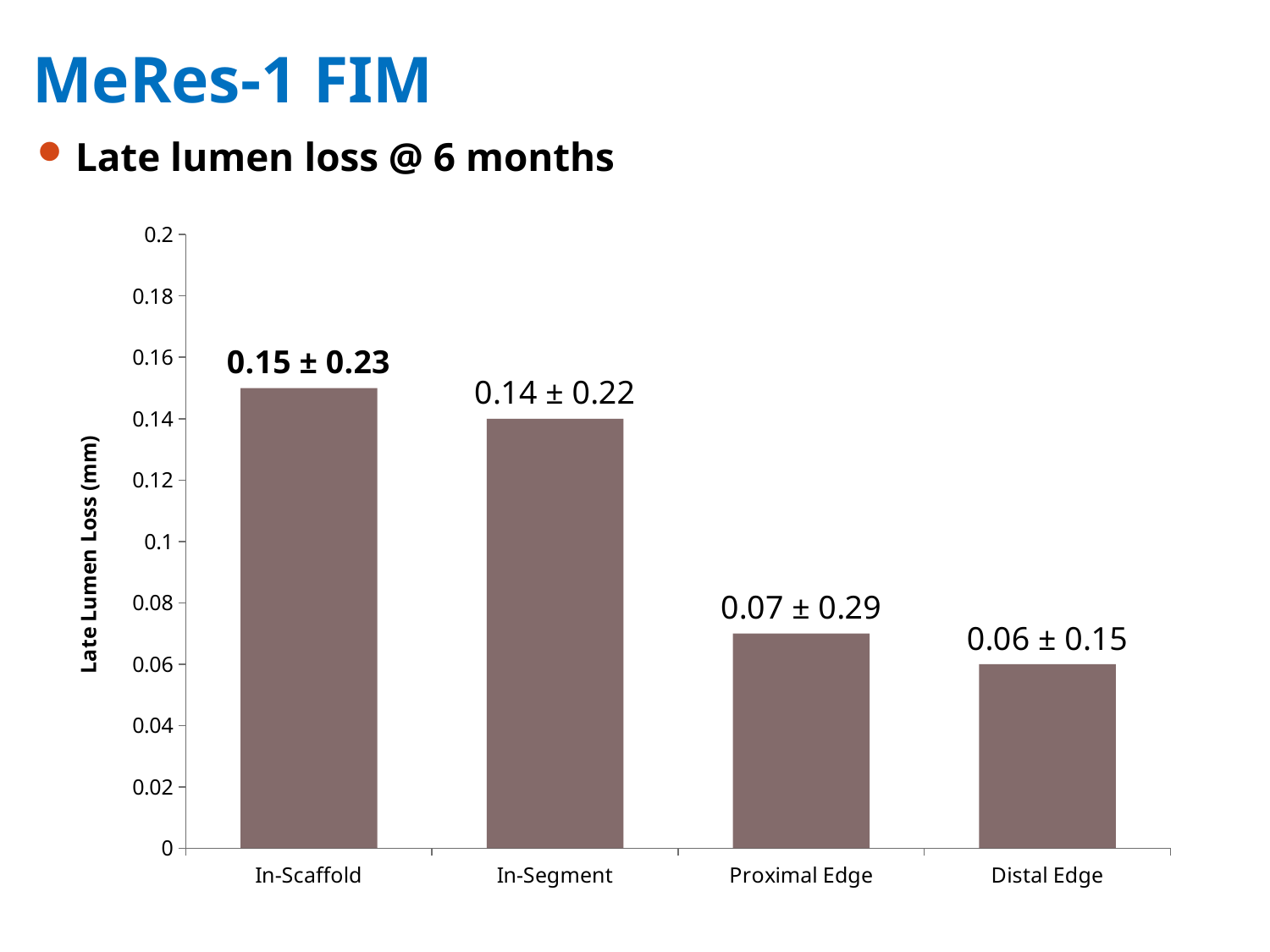
How many categories are shown on the x axis? 4 What kind of chart is shown on the slide? bar chart What is the late lumen loss value shown for Distal Edge? 0.06 ± 0.15 What is the label of the y axis? Late Lumen Loss (mm) Which category has the lowest late lumen loss? Distal Edge Is the value for Proximal Edge greater or less than 0.1? less Do the values rise or fall from left to right along the x axis? fall Which has a larger mean late lumen loss, In-Segment or Proximal Edge? In-Segment What is the late lumen loss value shown for In-Scaffold? 0.15 ± 0.23 What is the difference between the mean late lumen loss for In-Scaffold and In-Segment? 0.01 Which category has the highest late lumen loss? In-Scaffold What is the late lumen loss value shown for Proximal Edge? 0.07 ± 0.29